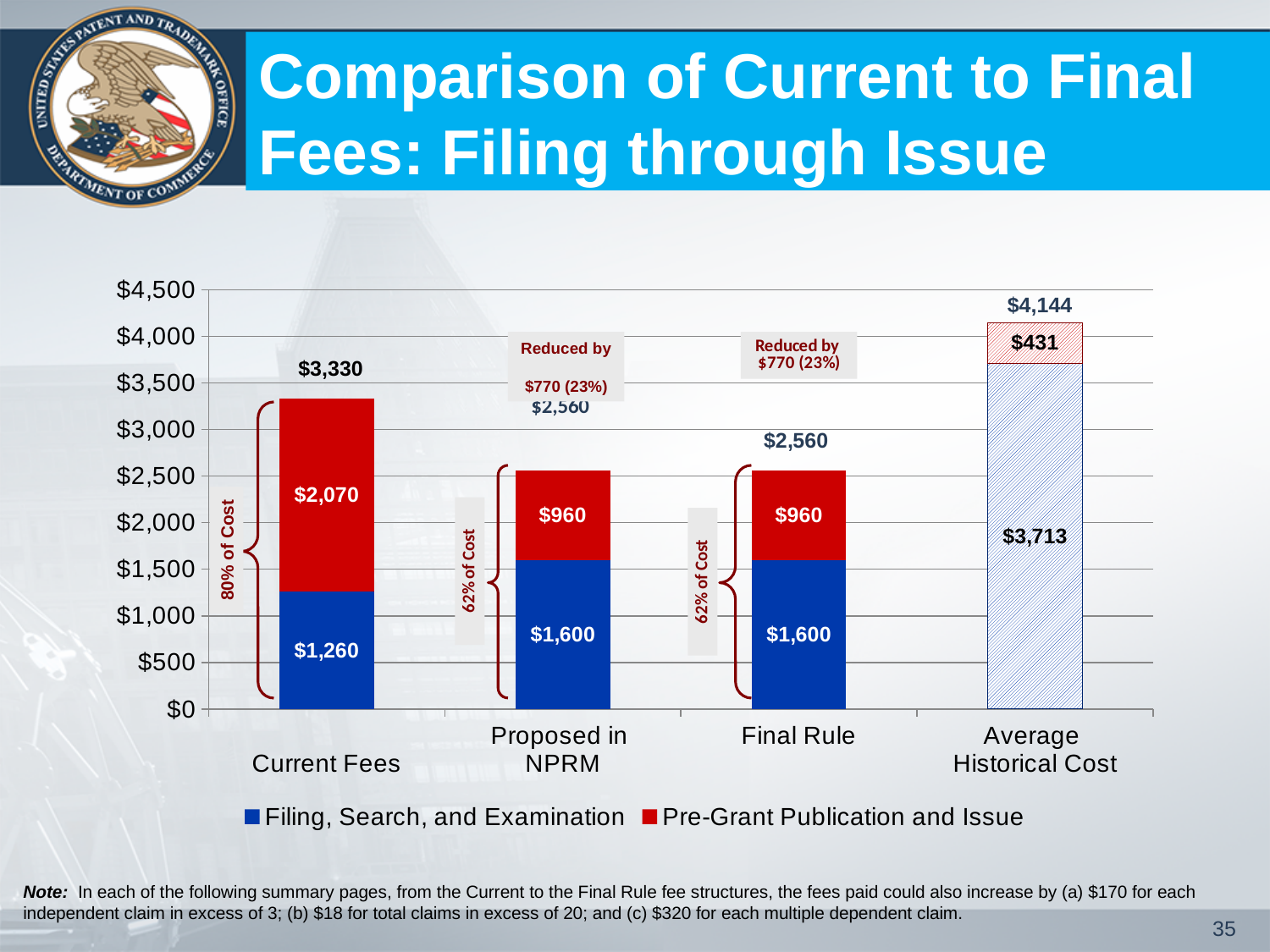
What is the Filing, Search, and Examination value for Current Fees? $1,260 What is the difference between the Current Fees total and the Final Rule total? $770 What is the Pre-Grant Publication and Issue value for Proposed in NPRM? $960 What is the total of the stacked bar for Current Fees? $3,330 Which category has the highest total bar? Average Historical Cost What is the Pre-Grant Publication and Issue value for Current Fees? $2,070 Which is larger: the Pre-Grant Publication and Issue value for Current Fees or for Final Rule? Current Fees What kind of chart is shown on the slide? Stacked bar chart How many categories are shown on the x axis? 4 What is the total of the stacked bar for Average Historical Cost? $4,144 What is the Filing, Search, and Examination value for Final Rule? $1,600 How many series does the legend list? 2